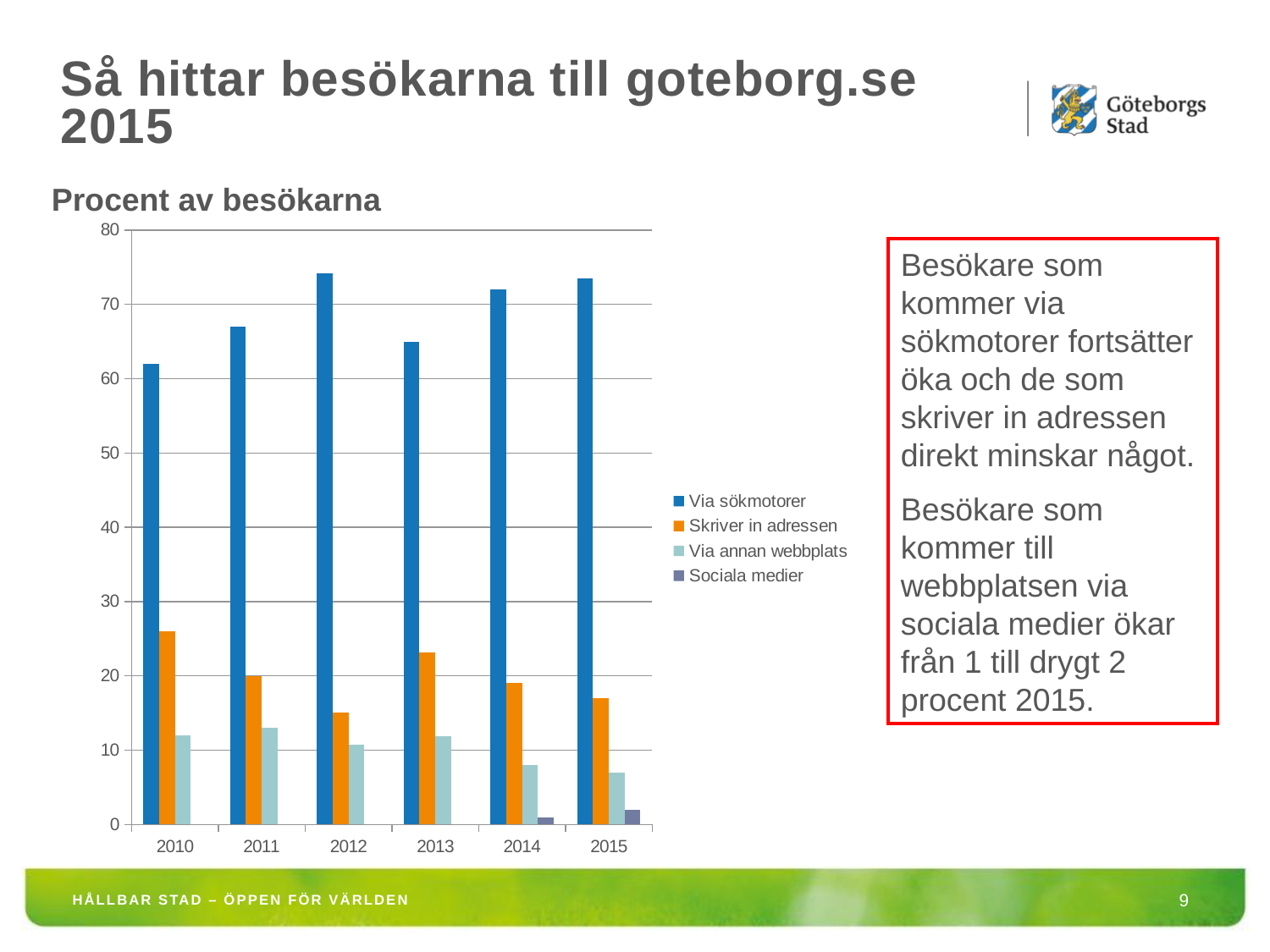
In which year is the value for Skriver in adressen highest? 2010 How many series does the legend list? 4 Does the value for Sociala medier rise or fall from 2014 to 2015? rise Which is larger: Via annan webbplats in 2011 or in 2014? 2011 Is the value for Via annan webbplats in 2014 greater or less than 10? less Is the value for Via sökmotorer in 2013 greater or less than 70? less Is the value for Skriver in adressen in 2012 greater or less than 20? less How many years are shown on the x axis? 6 In which year is the value for Via sökmotorer lowest? 2010 What is the title shown above the chart? Procent av besökarna What kind of chart is shown on the slide? bar chart